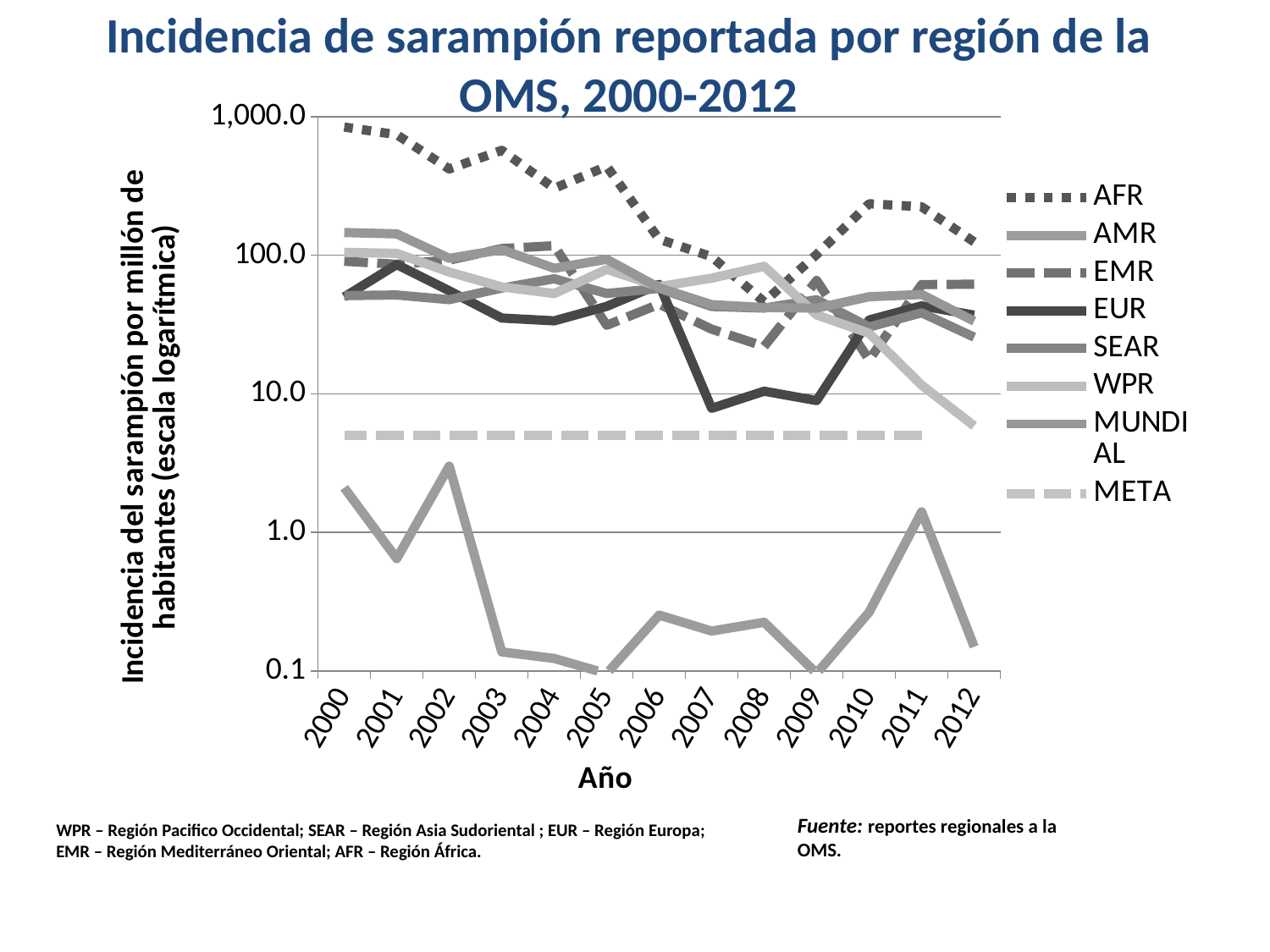
Is the value for WPR in 2012 greater or less than 10.0? less Does the AFR line overall rise or fall from 2000 to 2012? fall Which region has the highest reported measles incidence in 2000? AFR What kind of chart is shown on the slide? line chart Is the META line greater or less than 10.0? less Which is larger in 2012, the value for AFR or the value for AMR? AFR Is the value for AFR in 2000 greater or less than 100.0? greater How many years are shown along the x axis? 13 How many series does the legend list? 8 Which region has the lowest reported measles incidence in 2000? AMR What is the label of the x axis? Año